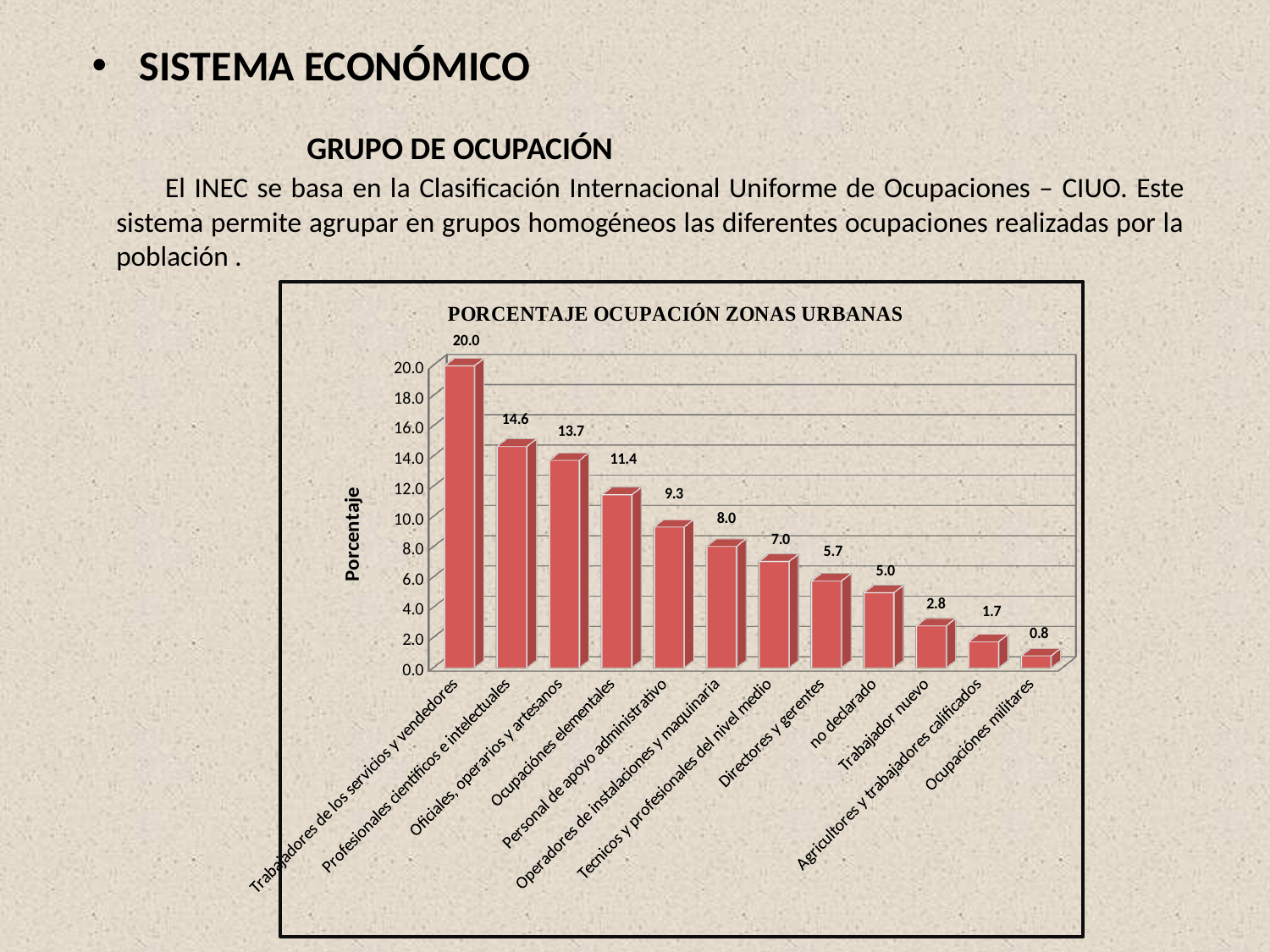
Which category has the highest value? Trabajadores de los servicios y vendedores Which is larger, the value for Personal de apoyo administrativo or the value for Operadores de instalaciones y maquinaria? Personal de apoyo administrativo What is the value for Directores y gerentes? 5.7 What is the value for Ocupaciones elementales? 11.4 What kind of chart is shown on the slide? bar chart Is the value for Oficiales, operarios y artesanos greater or less than 12.0? greater Do the values rise or fall from left to right along the x axis? fall What is the value for Profesionales científicos e intelectuales? 14.6 How many categories are shown on the x axis? 12 Which category has the lowest value? Ocupaciónes militares What is the title of the chart? PORCENTAJE OCUPACIÓN ZONAS URBANAS What is the difference between the values for Trabajadores de los servicios y vendedores and Profesionales científicos e intelectuales? 5.4